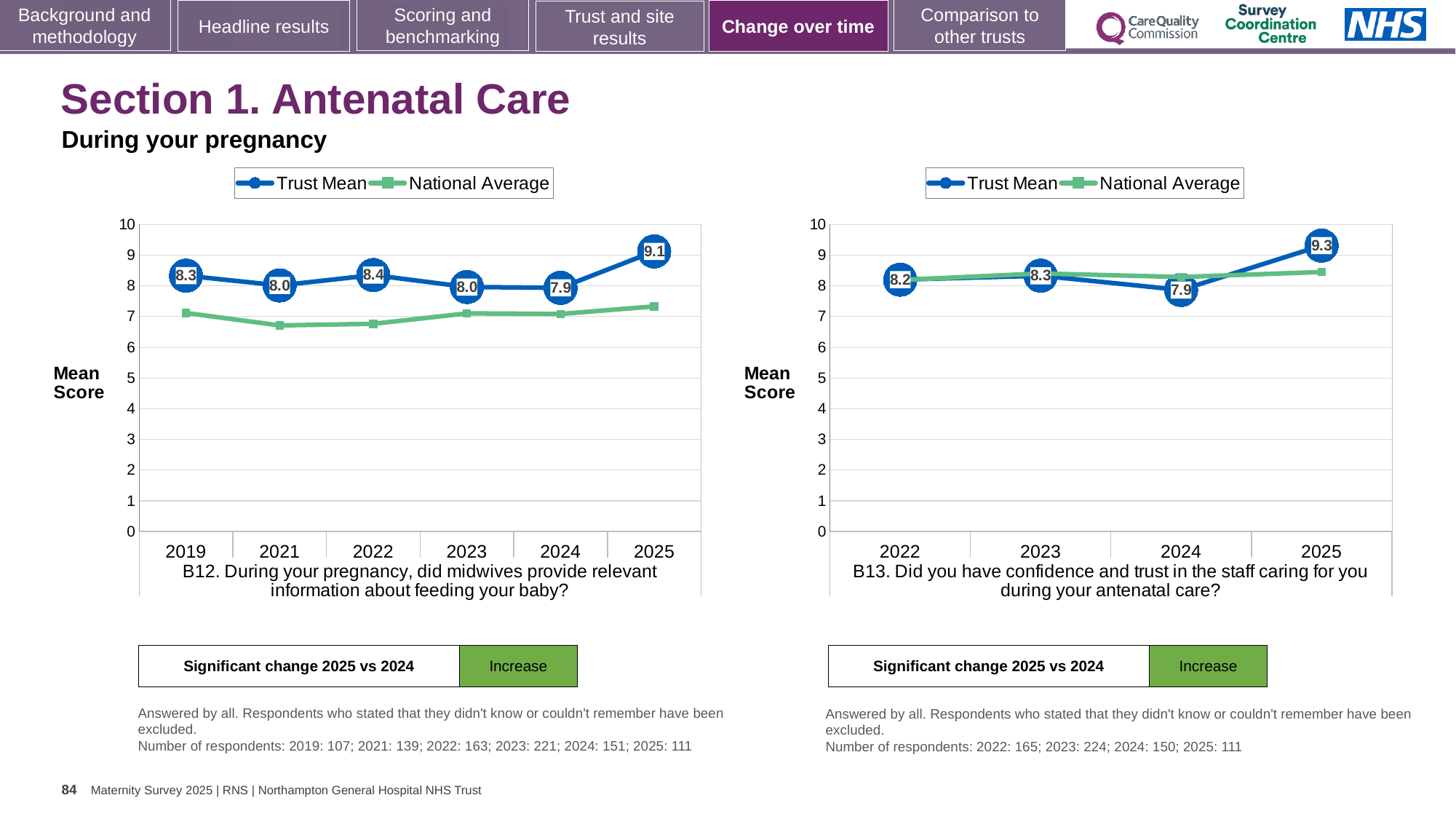
In the right chart (B13), what is the Trust Mean for 2025? 9.3 In the left chart (B12), what is the Trust Mean for 2025? 9.1 How many years are shown on the x axis of the right chart (B13)? 4 In the right chart (B13), what is the difference between the Trust Mean in 2025 and in 2024? 1.4 In the left chart (B12), which year has the highest Trust Mean? 2025 In the left chart (B12), which year has the lowest Trust Mean? 2024 In the right chart (B13), what is the Trust Mean for 2024? 7.9 In the left chart (B12), what is the difference between the Trust Mean in 2025 and in 2024? 1.2 In the left chart (B12), what is the Trust Mean for 2019? 8.3 In the right chart (B13), which year has the lowest Trust Mean? 2024 In the left chart (B12), is the National Average for 2021 greater or less than 7? less How many series does the legend of the left chart (B12) list? 2